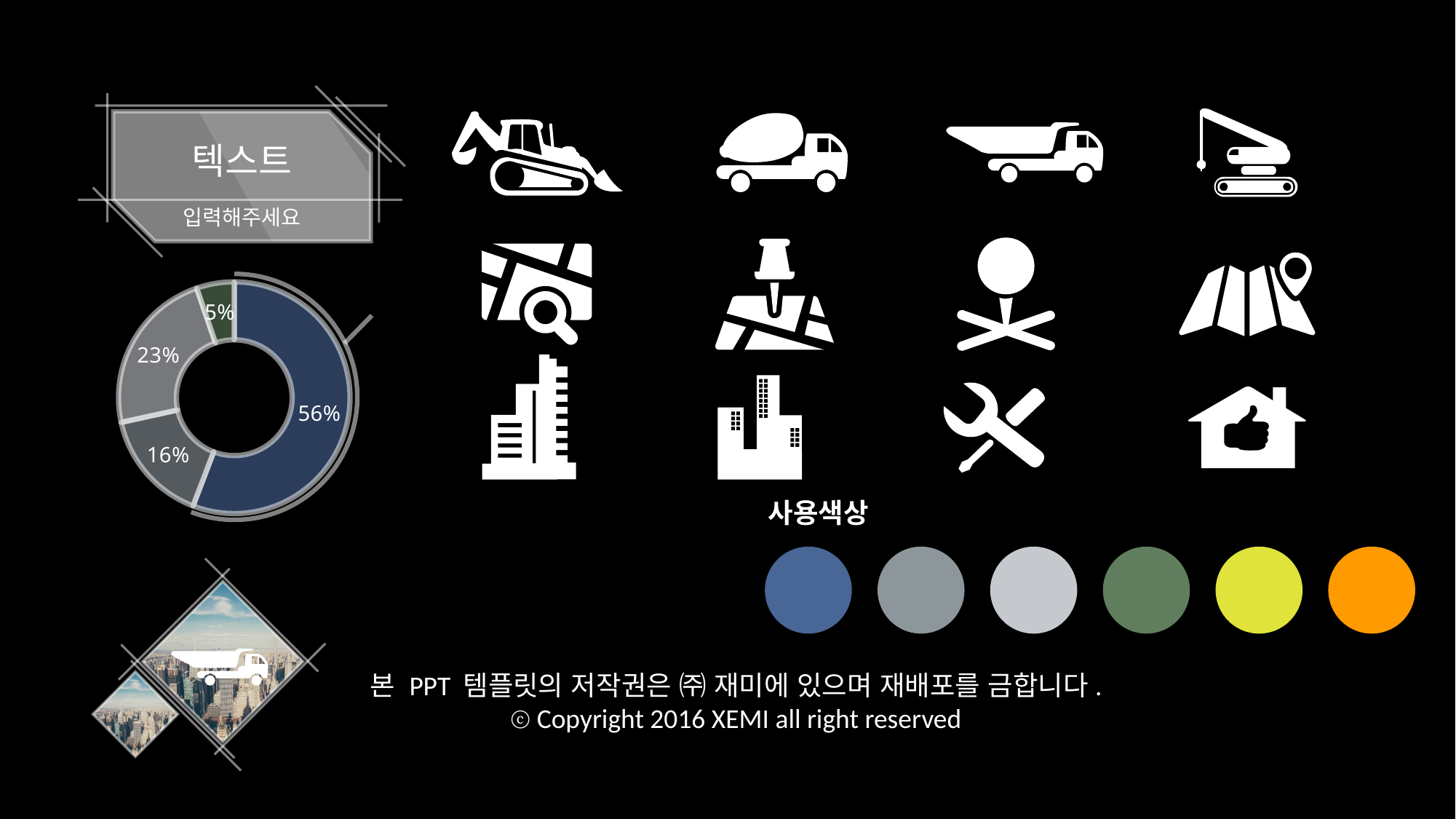
What do the four percentages in the donut chart add up to? 100% What percentage is shown on the light gray slice of the donut chart? 23% Which slice is larger in the donut chart, the 23% slice or the 16% slice? The 23% slice What is the difference between the largest slice (56%) and the smallest slice (5%) in the donut chart? 51% What kind of chart is shown on the left of the slide? Donut (pie) chart What is the largest percentage shown in the donut chart? 56% How many slices does the donut chart have? 4 What percentage is shown on the dark gray slice of the donut chart? 16% What percentage is shown on the dark blue slice of the donut chart? 56% What is the smallest percentage shown in the donut chart? 5% What colour is the largest slice of the donut chart? Dark blue What percentage is shown on the green slice of the donut chart? 5%